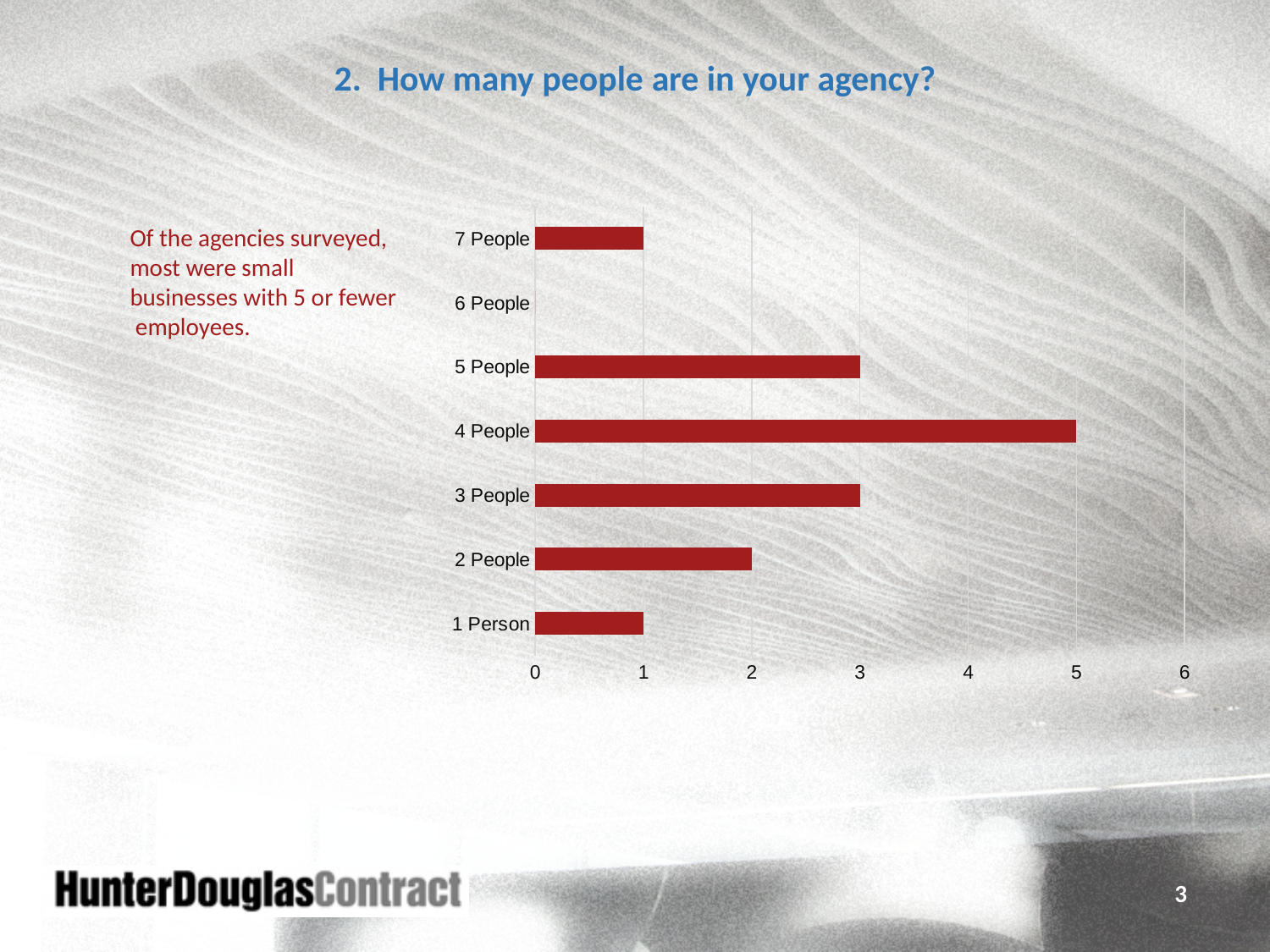
What kind of chart is shown on the slide? bar chart Which category has no bar at all (a value of 0)? 6 People What is the highest value shown on the horizontal axis? 6 Which is larger, the value for 5 People or the value for 7 People? 5 People What is the value for 2 People? 2 What is the value for 5 People? 3 Is the value for 4 People greater or less than 4? greater How many categories does the chart show? 7 What is the difference between the values for 4 People and 2 People? 3 What is the value for 4 People? 5 What is the value for 1 Person? 1 Which category has the highest value? 4 People